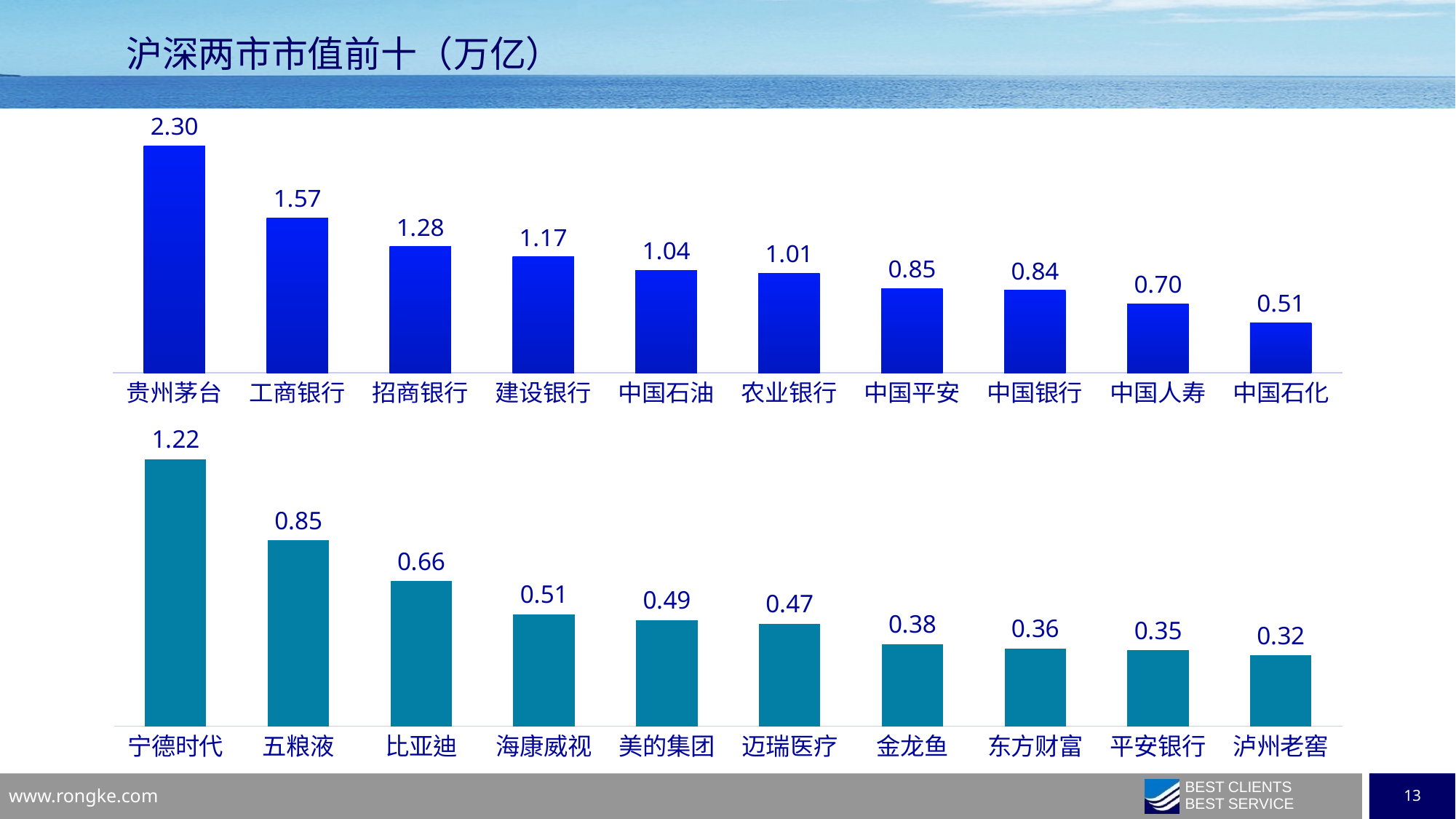
In the bottom chart, what is the value for 比亚迪? 0.66 In the bottom chart, which is larger, the value for 海康威视 or the value for 金龙鱼? 海康威视 In the bottom chart, which category has the highest value? 宁德时代 In the bottom chart, what is the difference between the values for 宁德时代 and 五粮液? 0.37 In the top chart, which category has the lowest value? 中国石化 How many categories are shown in the bottom chart? 10 In the top chart, what is the value for 贵州茅台? 2.30 How many categories are shown in the top chart? 10 In the top chart, what is the value for 中国平安? 0.85 In the top chart, what is the difference between the values for 贵州茅台 and 工商银行? 0.73 In the top chart, do the values rise or fall from left to right along the x axis? fall What kind of chart is the bottom chart? bar chart